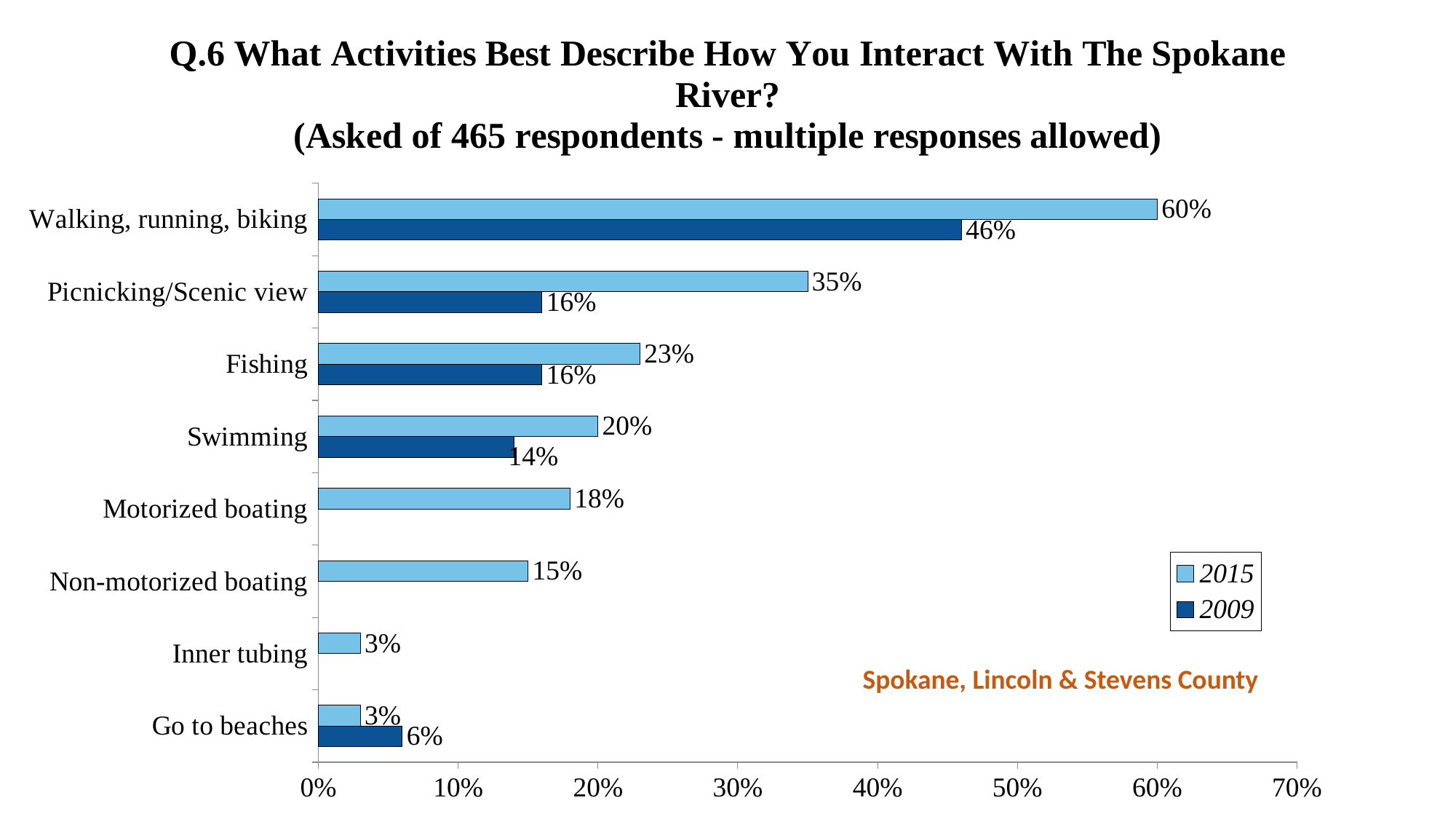
What is the 2009 value for Picnicking/Scenic view? 16% What is the 2009 value for Go to beaches? 6% Which activity has the highest 2015 value? Walking, running, biking What is the 2015 value for Walking, running, biking? 60% Which series is shown in the darker blue colour? 2009 What kind of chart is shown on the slide? Bar chart What is the difference between the 2015 and 2009 values for Picnicking/Scenic view? 19% Which is larger for Swimming, the 2015 value or the 2009 value? 2015 Which activity has the lowest 2009 value? Go to beaches What is the 2015 value for Motorized boating? 18% How many activity categories are shown on the chart? 8 How many series does the legend list? 2